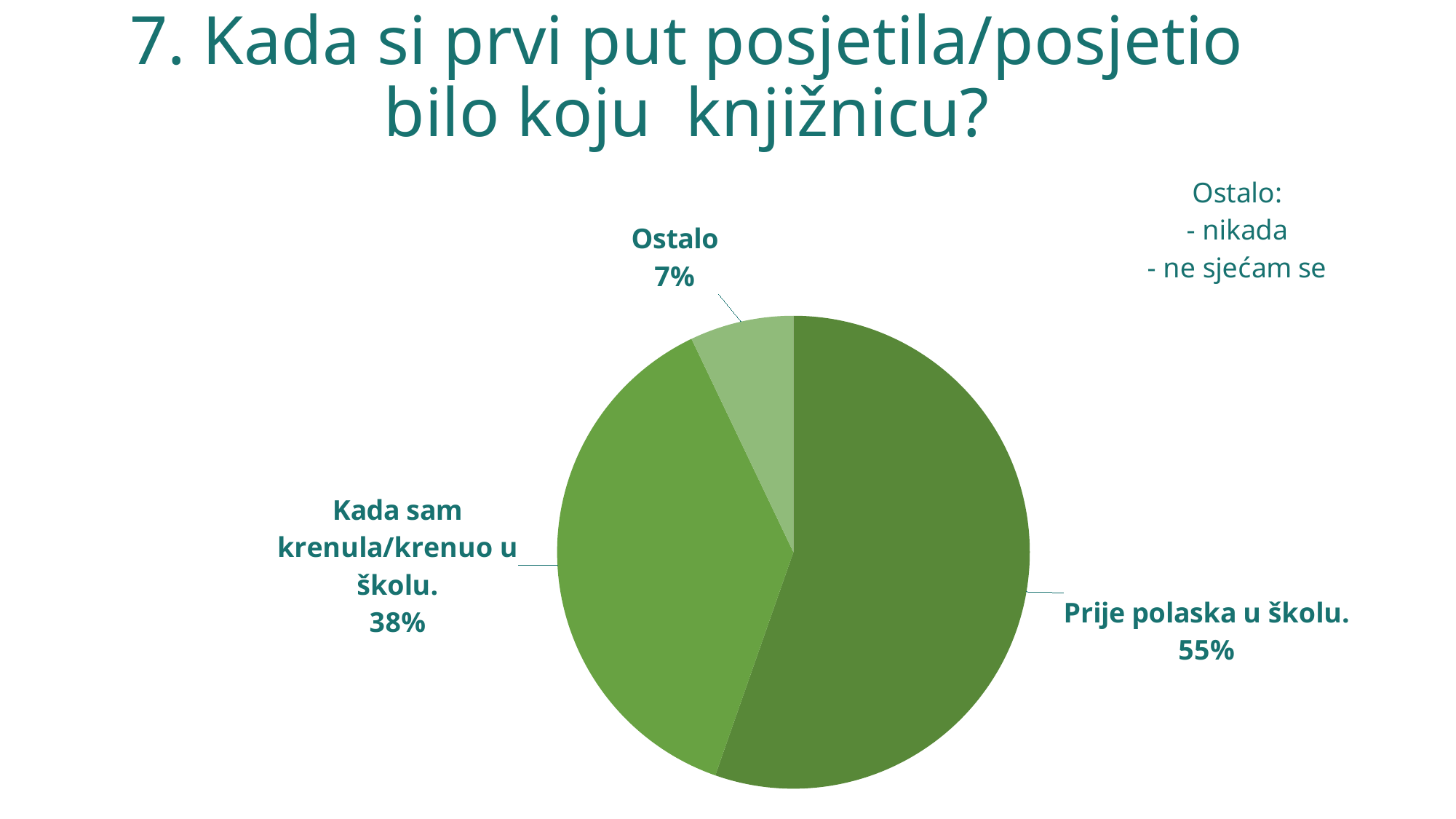
What is the difference in percentage points between "Prije polaska u školu." and "Kada sam krenula/krenuo u školu."? 17 percentage points Which category has the largest slice of the pie? Prije polaska u školu. What share of the pie does "Ostalo" have? 7% How many slices does the pie chart have? 3 What share of the pie does "Prije polaska u školu." have? 55% Which is larger, the slice for "Kada sam krenula/krenuo u školu." or the slice for "Ostalo"? Kada sam krenula/krenuo u školu. Which category has the smallest slice of the pie? Ostalo What kind of chart is shown on the slide? pie chart What is the title of the slide containing the pie chart? 7. Kada si prvi put posjetila/posjetio bilo koju knjižnicu? According to the note on the slide, which two responses are included in "Ostalo"? nikada; ne sjećam se What share of the pie does "Kada sam krenula/krenuo u školu." have? 38% What is the difference in percentage points between "Kada sam krenula/krenuo u školu." and "Ostalo"? 31 percentage points